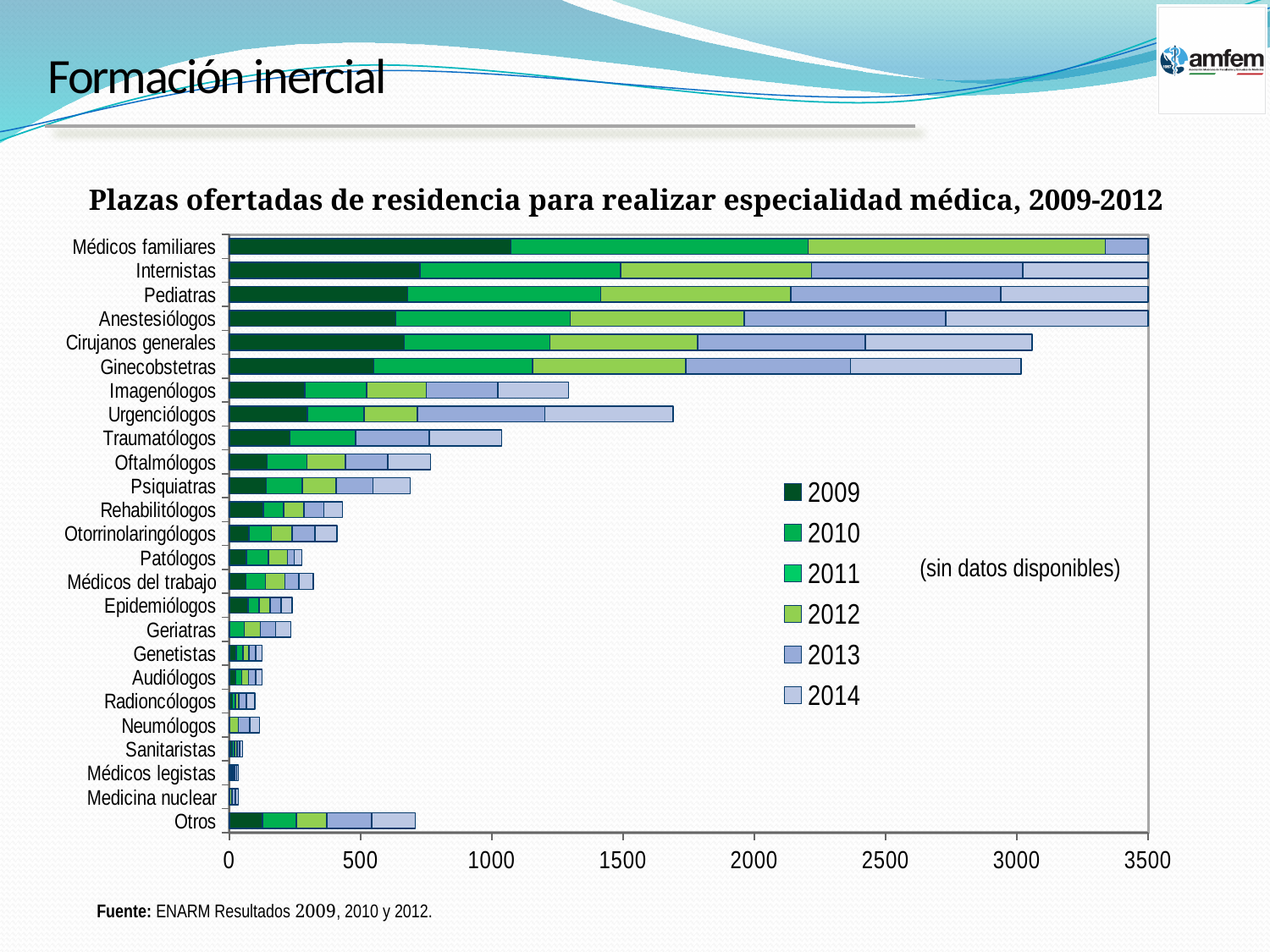
Which has the longer total bar, Traumatólogos or Oftalmólogos? Traumatólogos Is the total bar length for Cirujanos generales greater or less than 3000? greater How many specialty categories are plotted on the chart? 25 What kind of chart is shown on the slide? Stacked bar chart Is the total bar length for Otros greater or less than 500? greater Is the total bar length for Imagenólogos greater or less than 1500? less Which years are listed in the chart legend? 2009, 2010, 2011, 2012, 2013, 2014 What is the title of the chart? Plazas ofertadas de residencia para realizar especialidad médica, 2009-2012 Which has the longer total bar, Urgenciólogos or Imagenólogos? Urgenciólogos How many series does the chart legend list? 6